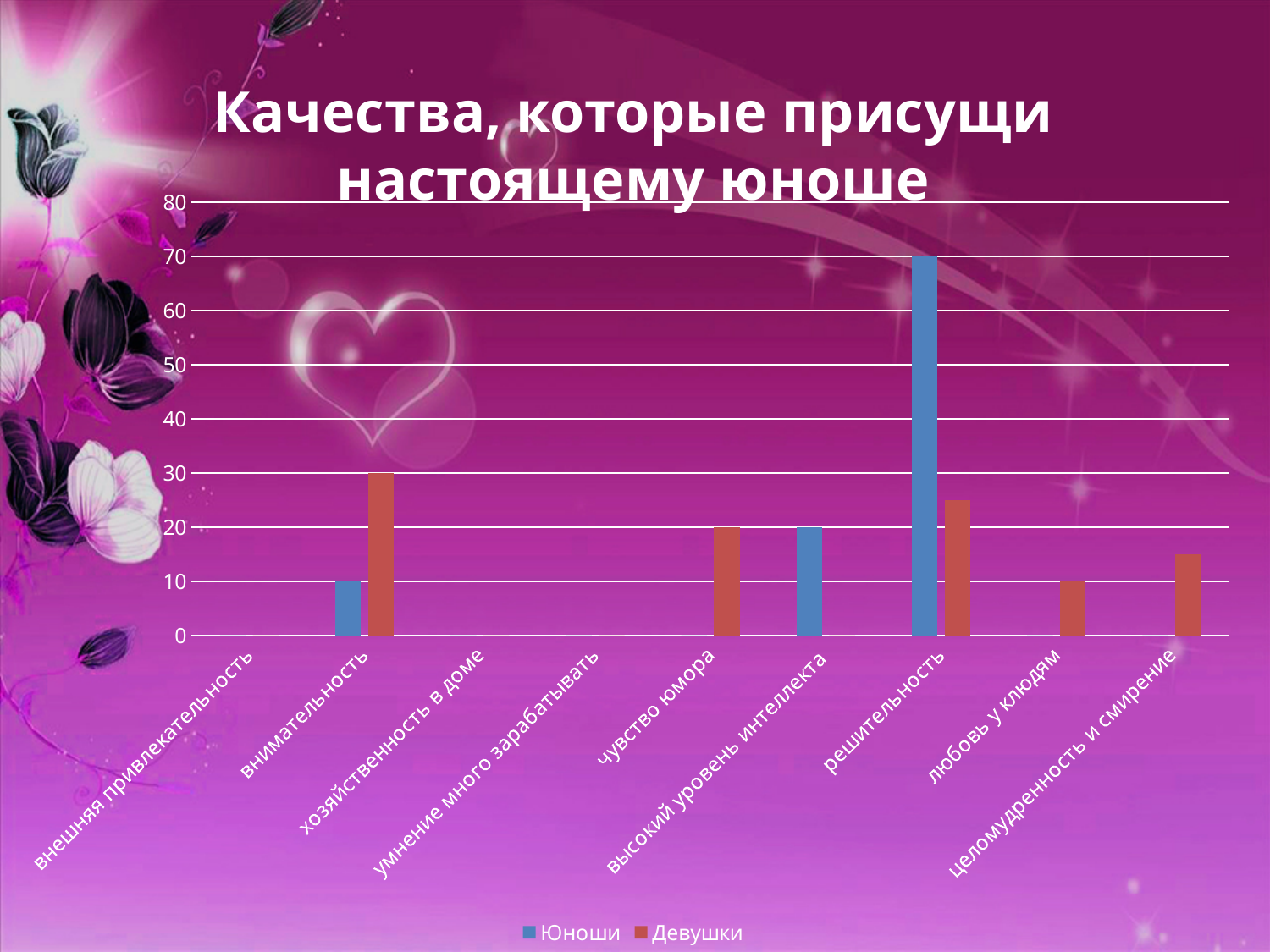
Is the value for Девушки in the category целомудренность и смирение greater or less than 10? greater What is the value for Девушки in the category чувство юмора? 20 Which category has the highest value for Юноши? решительность How many series does the legend list? 2 What is the difference between the Девушки and Юноши values in the category внимательность? 20 Is the value for Девушки in the category решительность greater or less than 20? greater What kind of chart is shown on the slide? bar chart What is the value for Юноши in the category решительность? 70 How many categories are shown on the x axis? 9 What is the value for Девушки in the category внимательность? 30 In the category внимательность, which series has the larger value, Юноши or Девушки? Девушки What is the value for Юноши in the category внимательность? 10